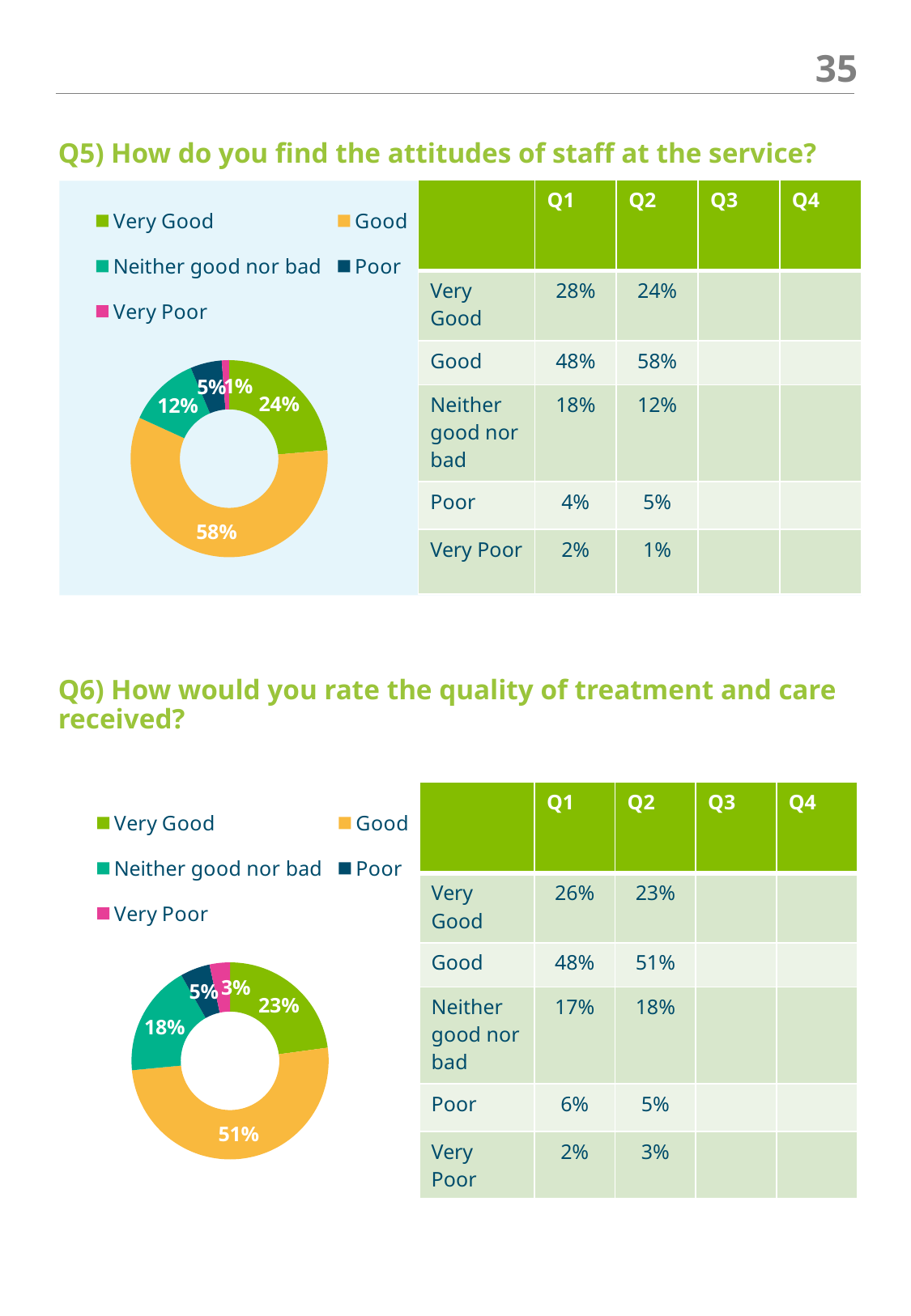
In the Q6 chart (quality of treatment and care), what is the difference between the Poor slice and the Very Poor slice? 2% In the Q5 chart (attitudes of staff), which category has the largest slice? Good In the Q5 chart (attitudes of staff), how many categories does the legend list? 5 In the Q6 chart (quality of treatment and care), what colour is the Good slice? Orange What type of chart is used for Q5 (attitudes of staff)? Doughnut chart In the Q5 chart (attitudes of staff), which category has the smallest slice? Very Poor In the Q5 chart (attitudes of staff), what share of the doughnut is labelled Very Good? 24% In the Q5 chart (attitudes of staff), what is the difference between the Good slice and the Very Good slice? 34% In the Q6 chart (quality of treatment and care), which is larger, the Very Good slice or the Neither good nor bad slice? Very Good In the Q6 chart (quality of treatment and care), what share of the doughnut is labelled Neither good nor bad? 18% In the Q6 chart (quality of treatment and care), what share of the doughnut is labelled Good? 51% In the Q5 chart (attitudes of staff), what share of the doughnut is labelled Good? 58%